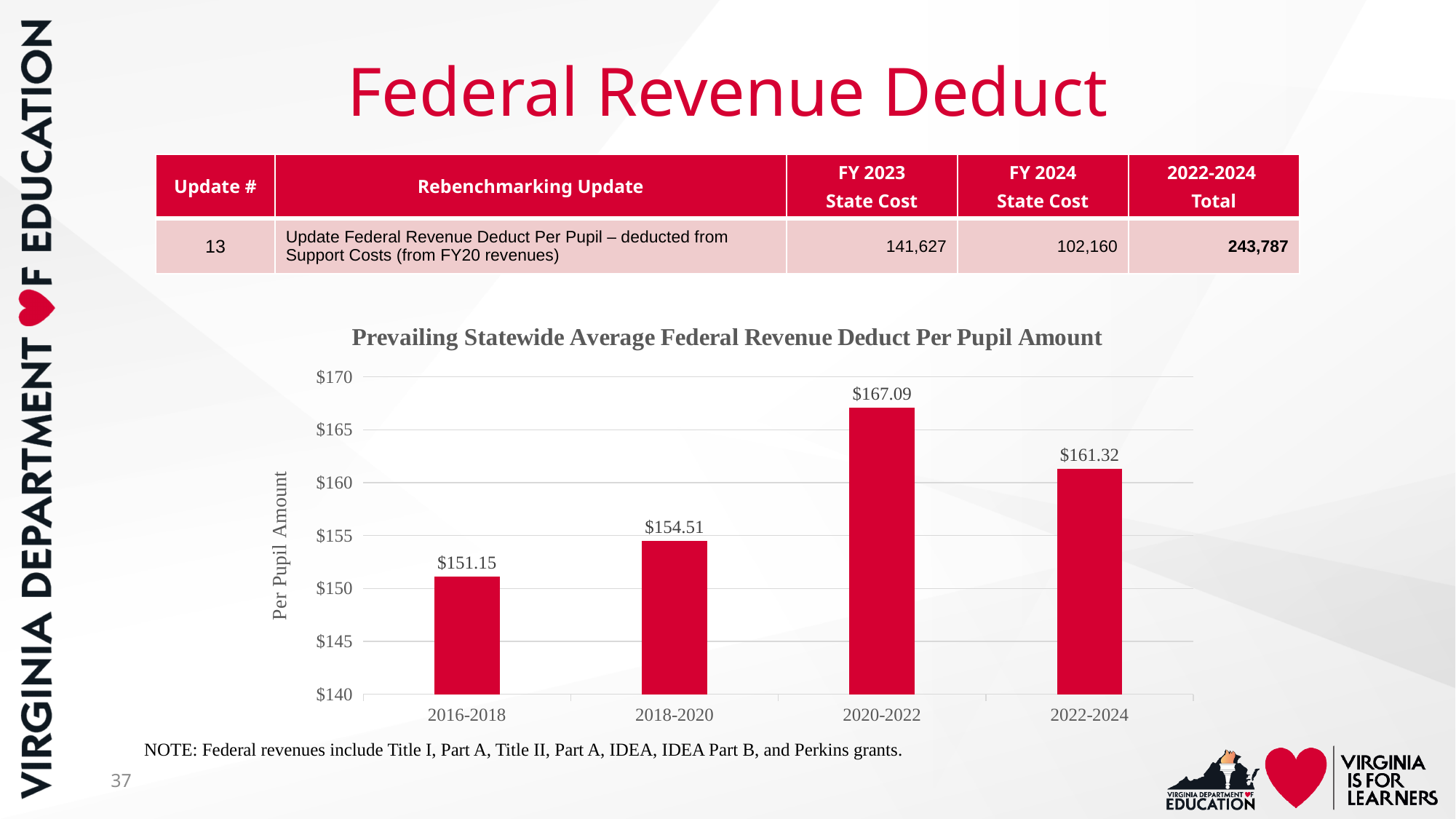
Is the value for 2018-2020 greater or less than $155? less What is the title of the chart? Prevailing Statewide Average Federal Revenue Deduct Per Pupil Amount What is the difference between the per pupil amounts for 2018-2020 and 2016-2018? $3.36 Which period has the lowest per pupil amount? 2016-2018 What is the per pupil amount for 2022-2024? $161.32 What kind of chart is shown on the slide? bar chart How many periods are shown on the x axis of the chart? 4 Which period has the highest per pupil amount? 2020-2022 What is the per pupil amount for 2020-2022? $167.09 What is the per pupil amount for 2016-2018? $151.15 What is the difference between the per pupil amounts for 2020-2022 and 2022-2024? $5.77 Which is larger, the per pupil amount for 2018-2020 or for 2022-2024? 2022-2024